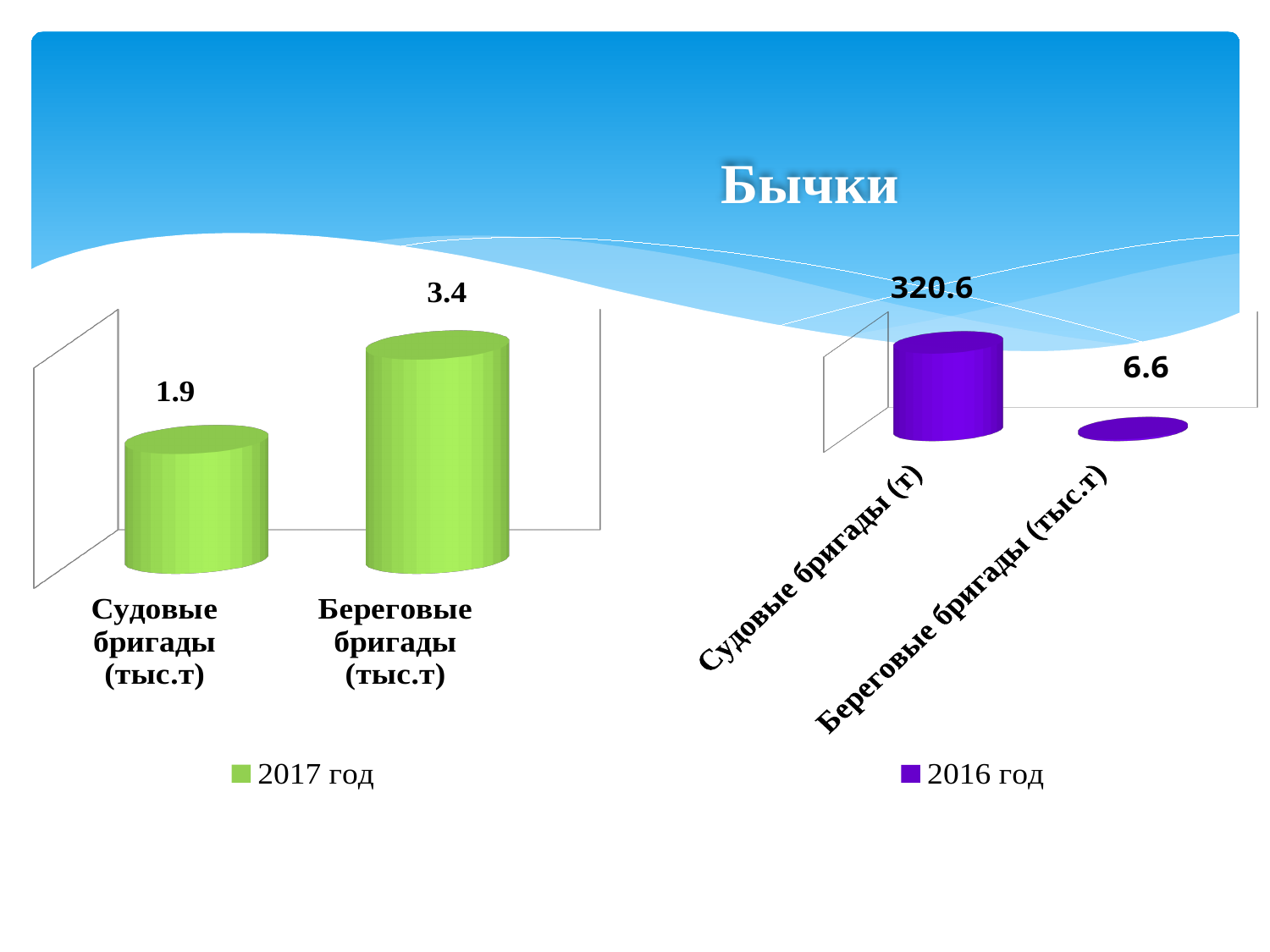
In the right chart (2016 год), what is the value for Береговые бригады (тыс.т)? 6.6 In the right chart (2016 год), which category has the lowest value? Береговые бригады (тыс.т) In the left chart (2017 год), which category has the highest value? Береговые бригады (тыс.т) In the left chart (2017 год), what is the value for Береговые бригады (тыс.т)? 3.4 What is the legend entry of the right chart? 2016 год In the right chart (2016 год), what is the value for Судовые бригады (т)? 320.6 In the left chart (2017 год), what is the difference between the values for Береговые бригады and Судовые бригады? 1.5 In the right chart (2016 год), which is larger: the value for Судовые бригады (т) or Береговые бригады (тыс.т)? Судовые бригады (т) How many categories are shown in the left chart (2017 год)? 2 In the left chart (2017 год), what is the value for Судовые бригады (тыс.т)? 1.9 What kind of chart is the left chart (2017 год)? Bar chart How many series does the legend of the right chart list? 1